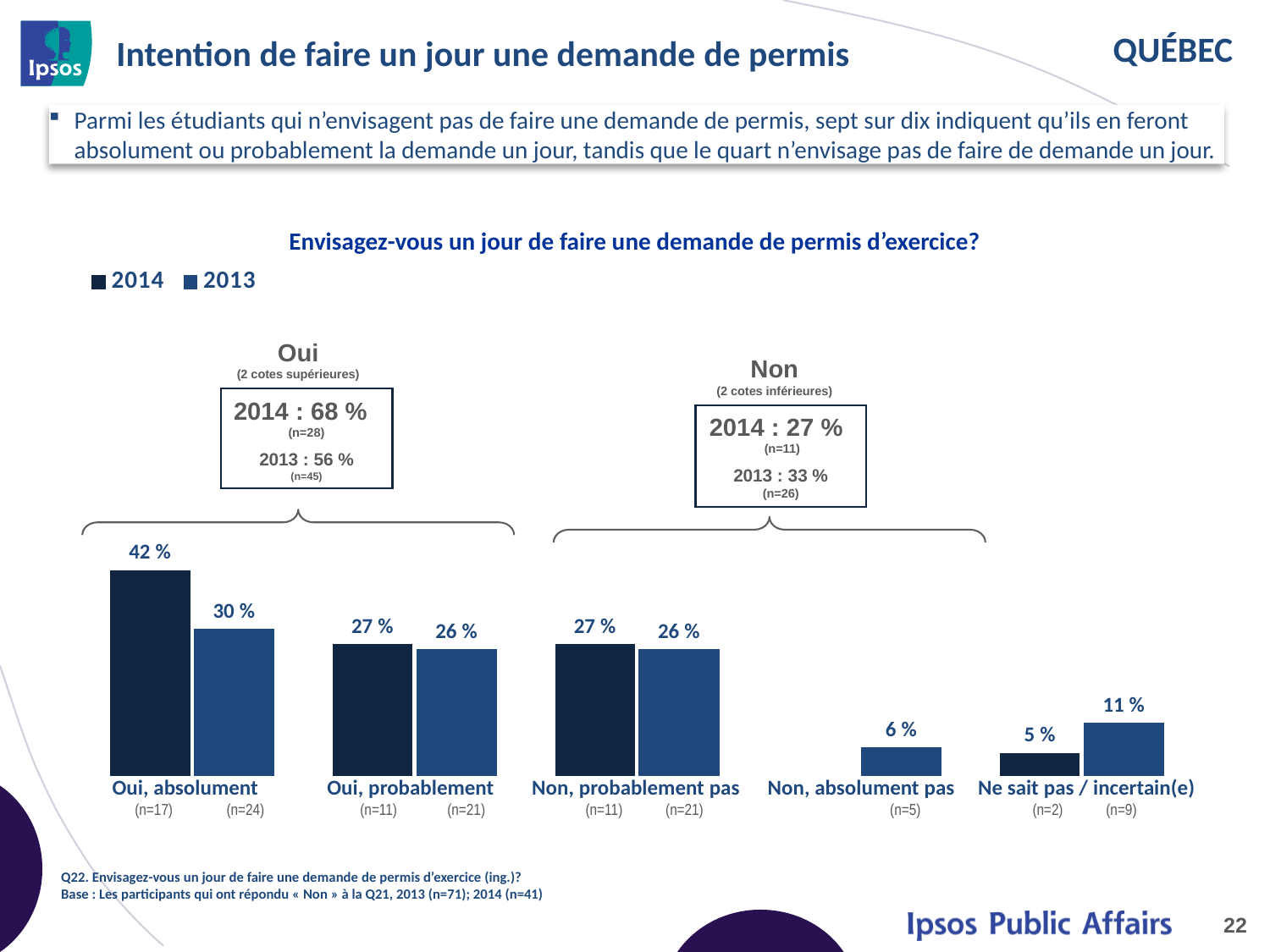
Which is larger for "Ne sait pas / incertain(e)": the 2014 value or the 2013 value? 2013 What is the 2013 value for "Oui, absolument"? 30 % What is the 2014 value for "Non, probablement pas"? 27 % Which category has the highest 2014 value? Oui, absolument What is the title of the chart? Envisagez-vous un jour de faire une demande de permis d'exercice? Which category has the lowest 2013 value? Non, absolument pas What is the 2014 value for "Oui, absolument"? 42 % How many series does the chart legend list? 2 What is the difference between the 2014 and 2013 values for "Oui, absolument"? 12 % What type of chart is shown on the slide? bar chart What is the 2013 value for "Ne sait pas / incertain(e)"? 11 % How many categories are shown on the x axis of the chart? 5